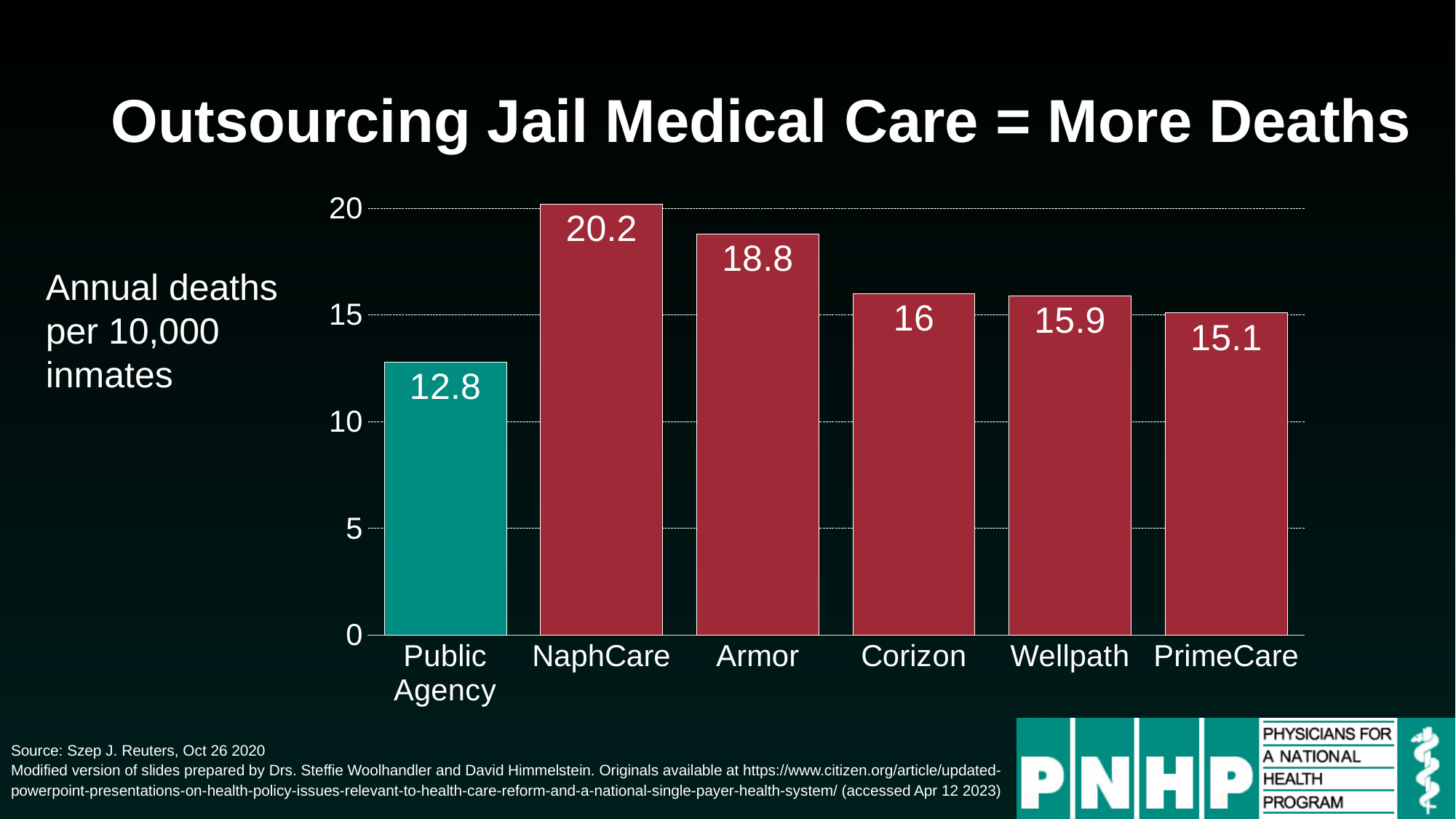
Which category has the lowest annual deaths per 10,000 inmates? Public Agency What kind of chart is shown on the slide? Bar chart What is the title of the slide? Outsourcing Jail Medical Care = More Deaths Which has a larger value, Armor or PrimeCare? Armor Which category has the highest annual deaths per 10,000 inmates? NaphCare What is the value shown for Corizon? 16 What is the difference between the values for NaphCare and Public Agency? 7.4 What is the difference between the values for Armor and Wellpath? 2.9 How many categories are shown on the x axis? 6 What is the value shown for PrimeCare? 15.1 What is the value shown for NaphCare? 20.2 What is the annual deaths per 10,000 inmates value for Public Agency? 12.8